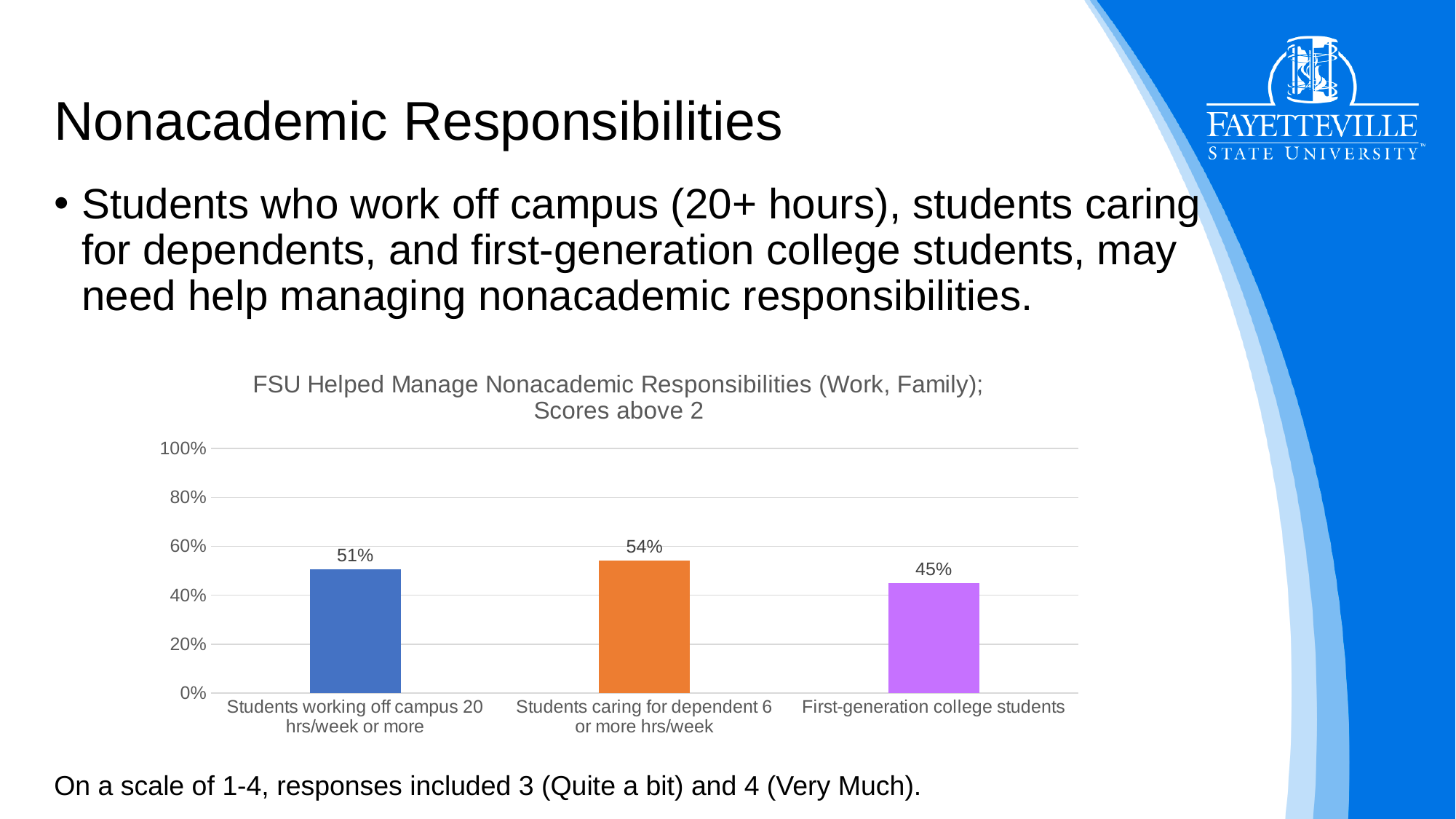
How many categories are shown in the chart? 3 Which category has the highest value? Students caring for dependent 6 or more hrs/week What is the title of the chart? FSU Helped Manage Nonacademic Responsibilities (Work, Family); Scores above 2 What kind of chart is shown on the slide? Bar chart What is the value for First-generation college students? 45% What is the difference between the values for Students caring for dependent 6 or more hrs/week and First-generation college students? 9% Which is larger: the value for Students working off campus 20 hrs/week or more or the value for First-generation college students? Students working off campus 20 hrs/week or more Which category has the lowest value? First-generation college students What is the value for Students caring for dependent 6 or more hrs/week? 54% Is the value for First-generation college students greater or less than 60%? less What is the difference between the values for Students working off campus 20 hrs/week or more and First-generation college students? 6% What is the value for Students working off campus 20 hrs/week or more? 51%